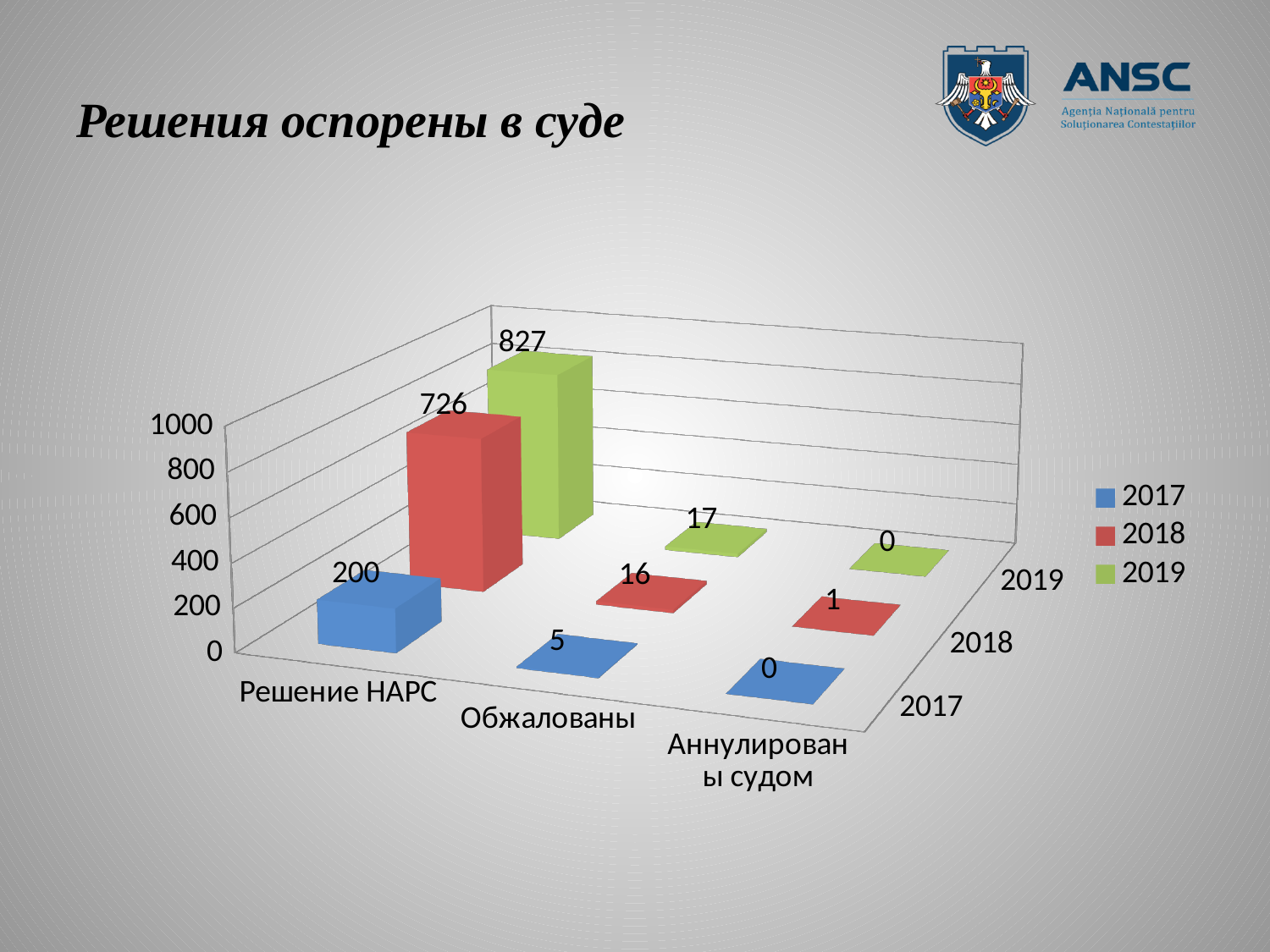
Which year has the highest value for Решение НАРС? 2019 What is the value for Обжалованы in 2018? 16 What is the value for Решение НАРС in 2017? 200 Which is larger: Обжалованы in 2019 or Обжалованы in 2018? Обжалованы in 2019 What is the difference between the Решение НАРС values for 2019 and 2018? 101 Which year has the lowest value for Обжалованы? 2017 Is the value for Решение НАРС in 2018 greater or less than 600? greater What is the value for Решение НАРС in 2019? 827 What is the value for Аннулированы судом in 2017? 0 How many series does the legend list? 3 How many categories are shown on the chart? 3 What type of chart is shown on the slide? bar chart